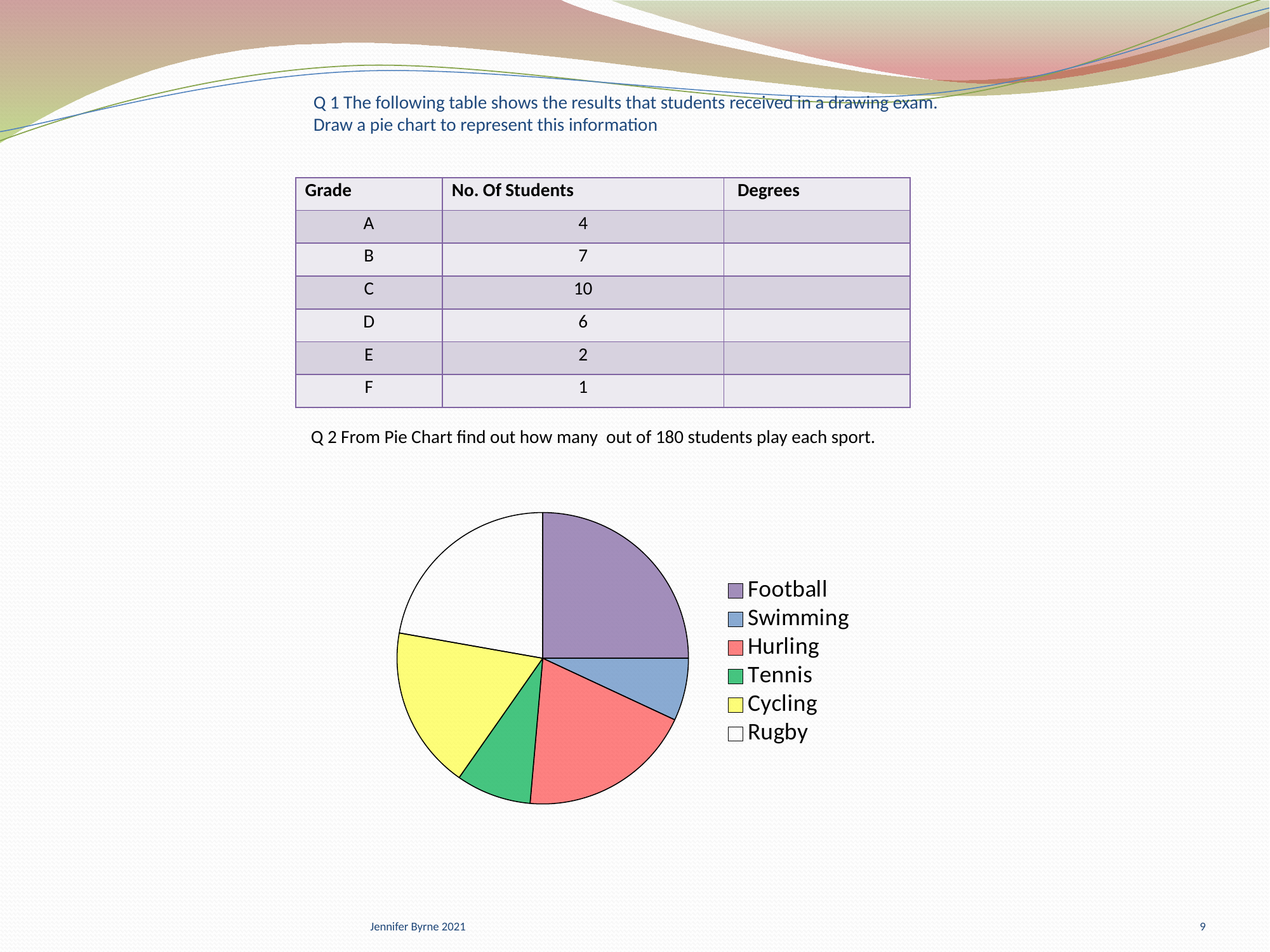
Which sport has the smallest slice in the pie chart? Swimming In the pie chart, which slice is larger, Hurling or Swimming? Hurling In the pie chart, which slice is larger, Football or Tennis? Football Which sport is listed first in the pie chart's legend? Football How many slices does the pie chart have? 6 What kind of chart is shown on the slide? pie chart What colour is the Rugby slice in the pie chart? white In the pie chart, which slice is larger, Cycling or Tennis? Cycling